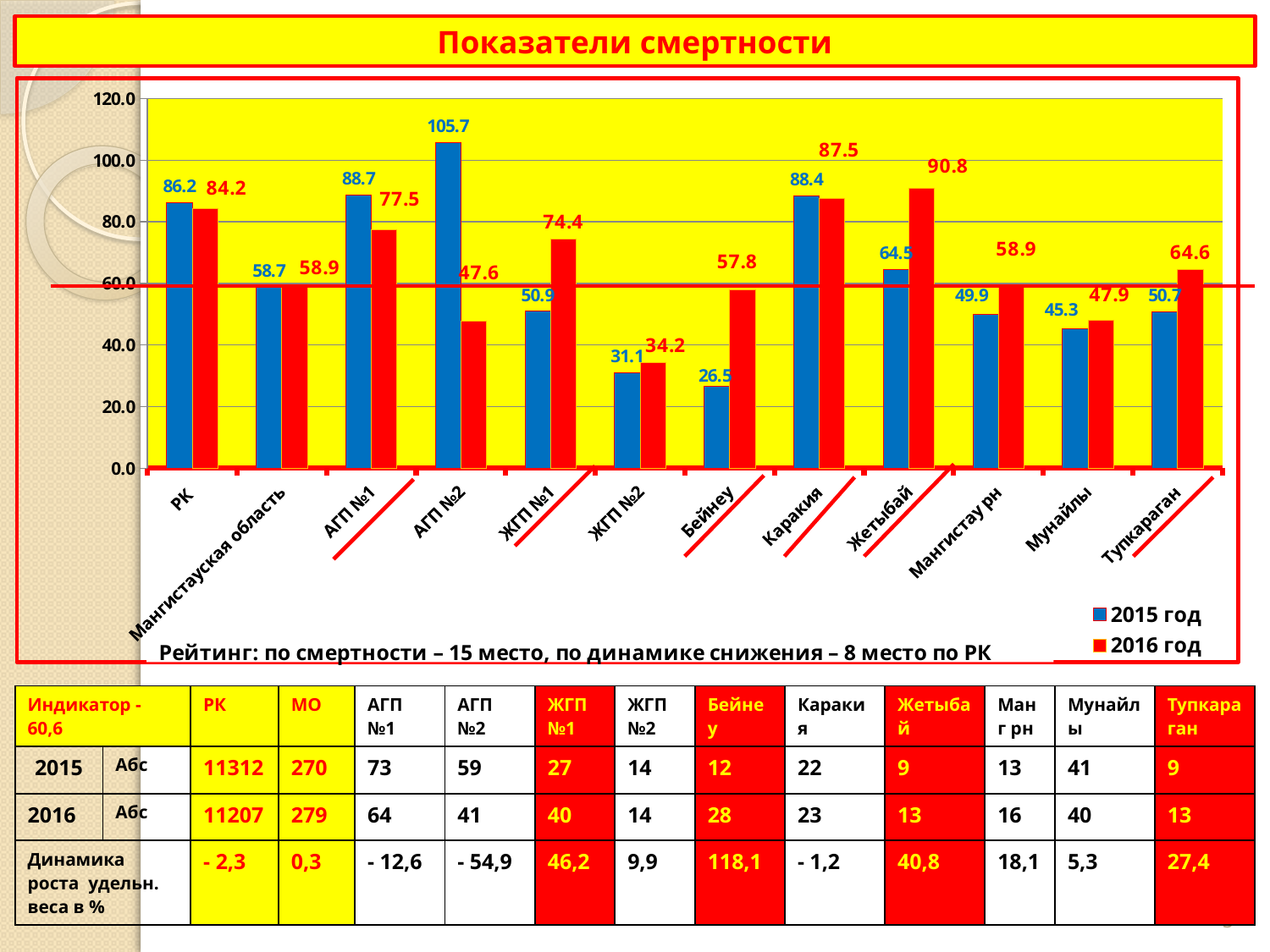
How many series does the chart legend list? 2 Which category has the lowest 2015 год value? Бейнеу What is the 2015 год value for АГП №2? 105.7 How many categories are shown along the x axis of the chart? 12 What is the 2016 год value for Жетыбай? 90.8 What is the title of the chart? Показатели смертности What is the 2016 год value for Бейнеу? 57.8 What type of chart is shown on the slide? bar chart Which category has the lowest 2016 год value? ЖГП №2 Which is larger for ЖГП №1: the 2015 год value or the 2016 год value? 2016 год Which category has the highest 2015 год value? АГП №2 What is the difference between the 2015 год and 2016 год values for АГП №2? 58.1